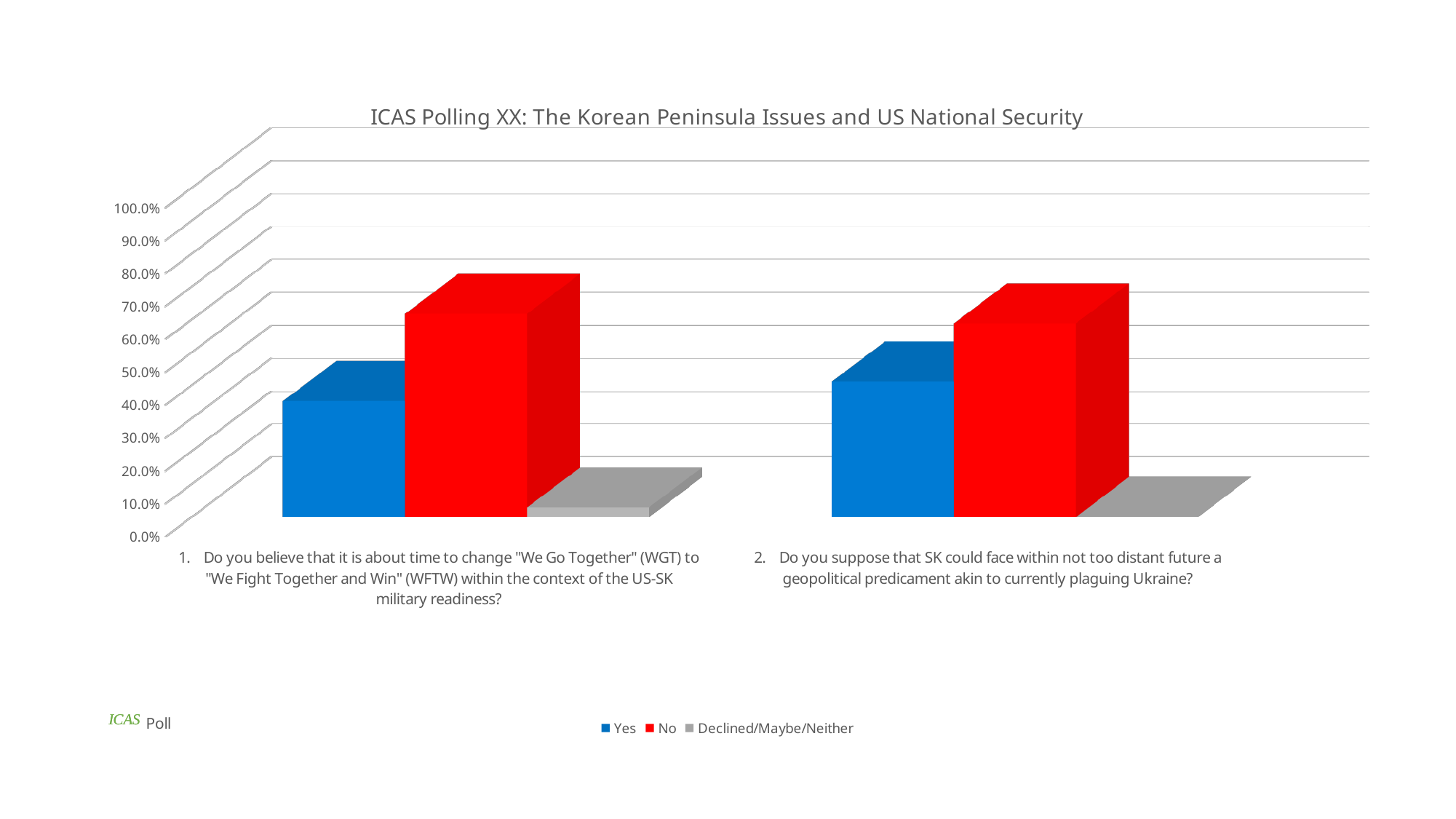
Is the "No" value for question 1 greater or less than 50.0%? greater What is the title of the chart? ICAS Polling XX: The Korean Peninsula Issues and US National Security Is the "Declined/Maybe/Neither" value for question 1 greater or less than 10.0%? less Which colour represents the "No" series in the legend? red What kind of chart is shown on the slide? bar chart For question 2, which is larger: the "Yes" value or the "No" value? No Is the "Yes" value for question 1 greater or less than 60.0%? less For question 1, which response has the lowest value? Declined/Maybe/Neither How many series does the legend list? 3 How many poll questions (categories) are plotted on the x axis? 2 For question 1, which response has the highest value? No